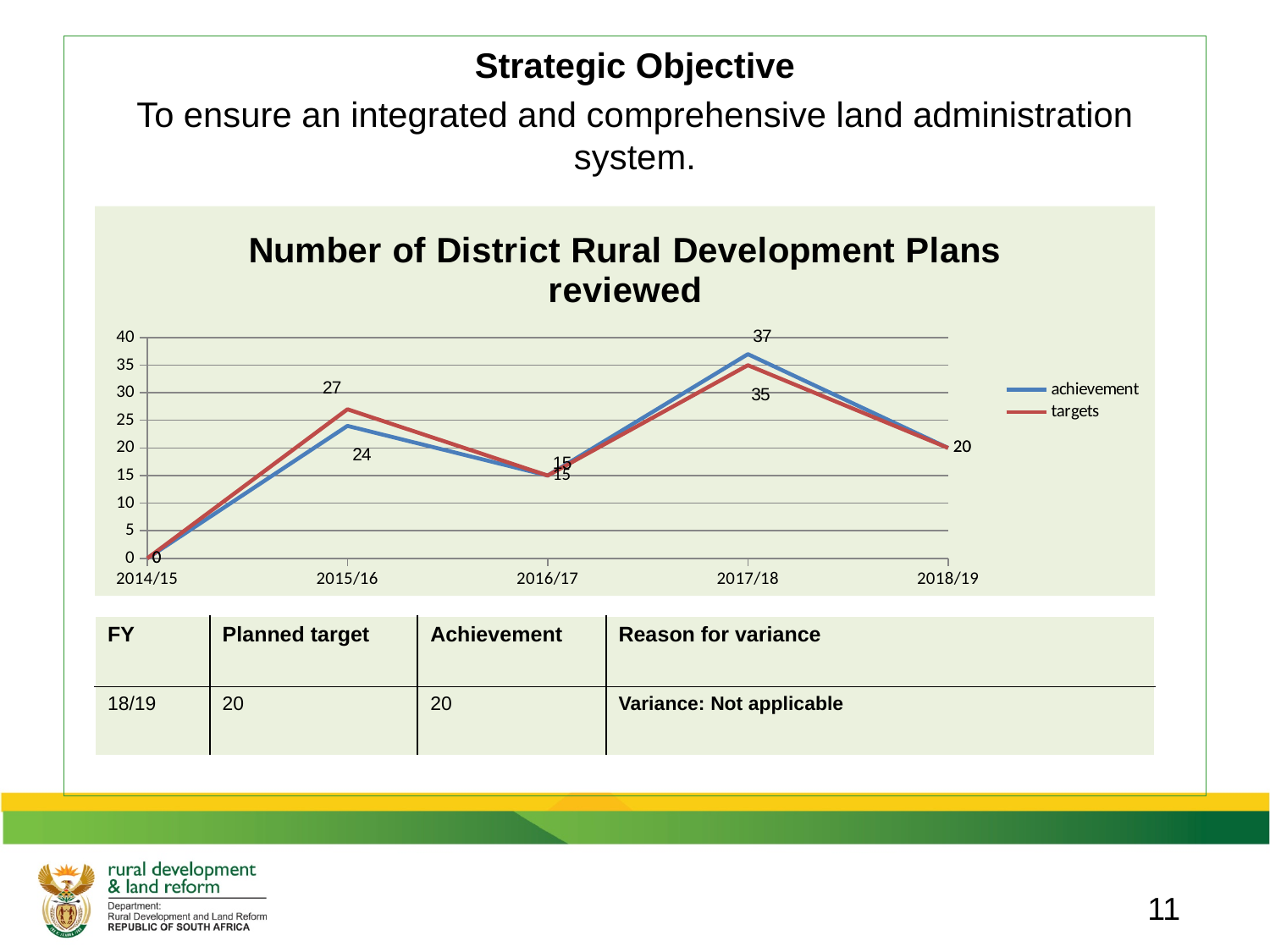
Do the achievement values rise or fall from 2017/18 to 2018/19? fall What is the achievement value for 2015/16? 24 In which financial year is the targets value lowest? 2014/15 What is the title of the chart? Number of District Rural Development Plans reviewed What is the achievement value for 2017/18? 37 What type of chart is shown on the slide? line chart What is the targets value for 2015/16? 27 How many financial years are plotted along the x axis? 5 What is the difference between the targets value and the achievement value in 2015/16? 3 In which financial year is the achievement value highest? 2017/18 How many series does the chart legend list? 2 In 2017/18, which is larger: the achievement value or the targets value? achievement